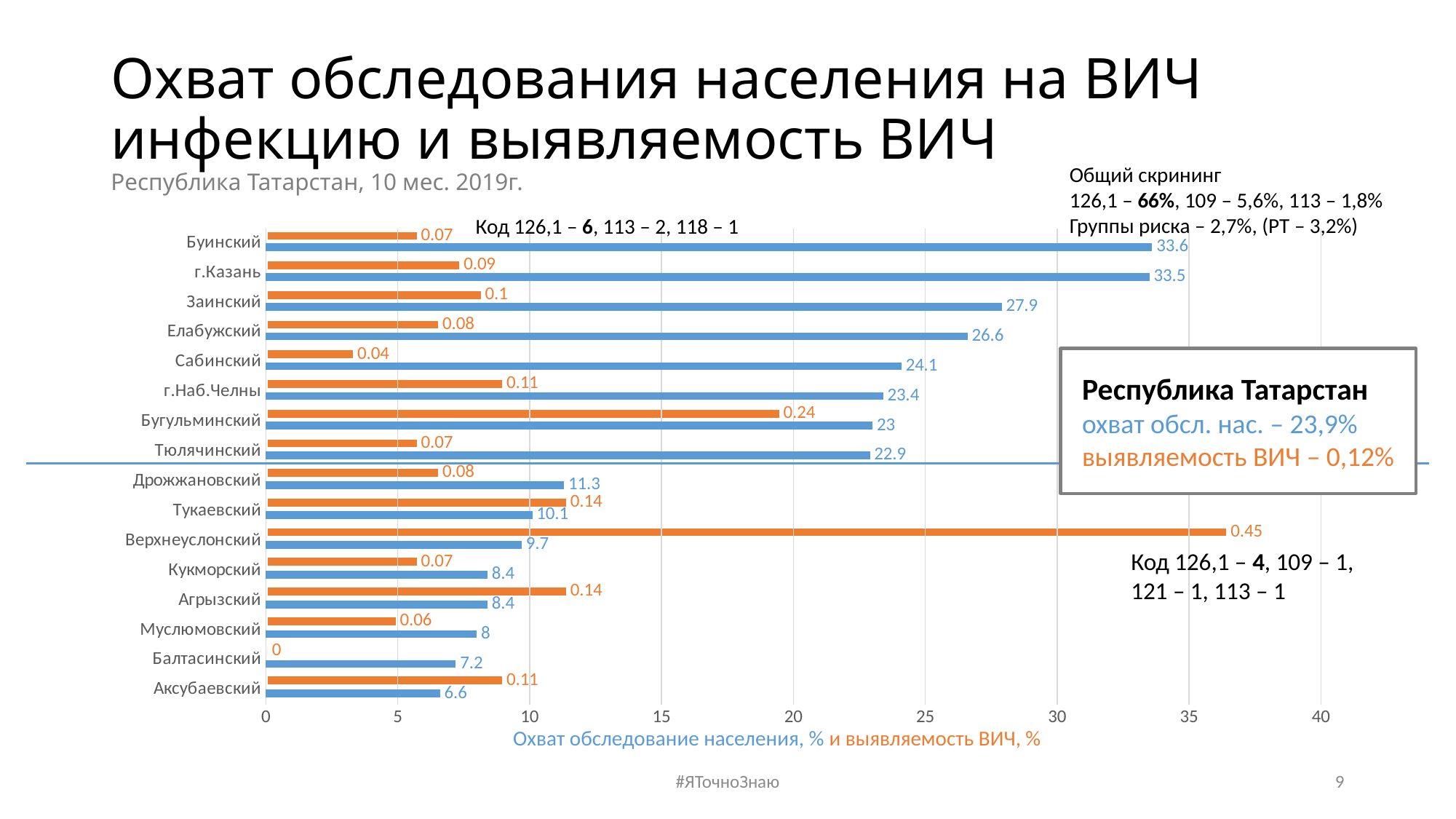
Which district has the lowest orange bar value (выявляемость ВИЧ)? Балтасинский What type of chart is shown on the slide? bar chart Which district has a larger blue bar value: Сабинский or Тюлячинский? Сабинский What is the blue bar value for Аксубаевский? 6.6 What is the blue bar value (охват обследования населения, %) for Заинский? 27.9 What is the orange bar value (выявляемость ВИЧ, %) for Бугульминский? 0.24 Is the blue bar value for Дрожжановский greater or less than 15? less What is the difference between the blue bar values for Буинский and г.Казань? 0.1 Which district has the highest orange bar value (выявляемость ВИЧ)? Верхнеуслонский What is the x-axis title of the chart? Охват обследование населения, % и выявляемость ВИЧ, % Which district has the highest blue bar value (охват обследования населения)? Буинский How many districts (categories) are plotted on the chart? 16